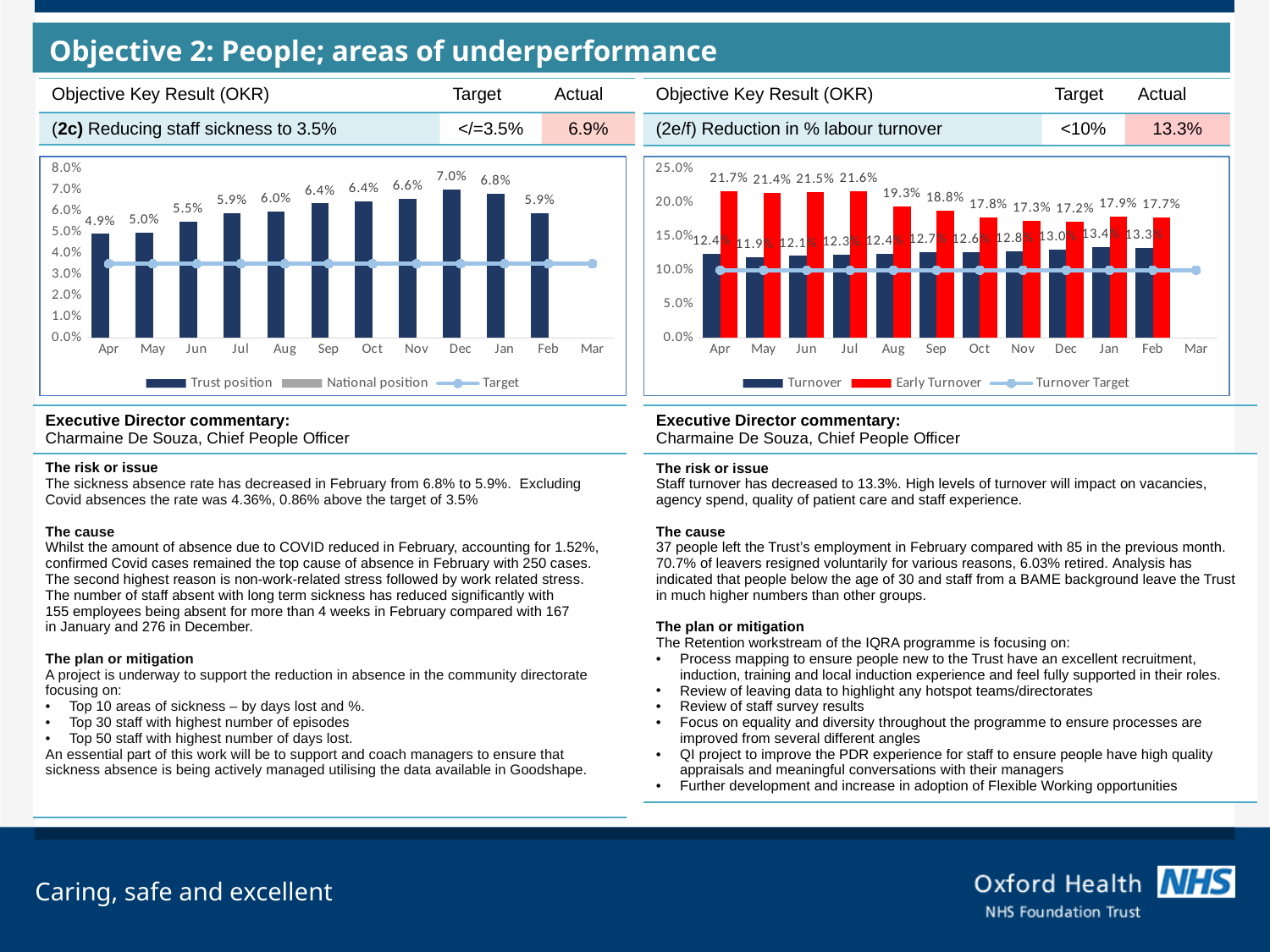
What kind of chart is the right chart? Bar chart with a line On the left chart, which month has the highest Trust position value? Dec On the left chart, is the Trust position value for Apr greater or less than 4.0%? greater On the right chart, what is the Turnover value for Jan? 13.4% On the left chart, which month has the lowest Trust position value? Apr On the right chart, what is the difference between the Early Turnover values for Jul and Aug? 2.3% On the left chart, what is the difference between the Trust position values for Jan and Feb? 0.9% On the left chart, how many series does the legend list? 3 On the right chart, which month has the lowest Early Turnover value? Dec On the right chart, which is larger in Sep: Turnover or Early Turnover? Early Turnover On the right chart, what is the Early Turnover value for Apr? 21.7% On the left chart, what is the Trust position value for Dec? 7.0%